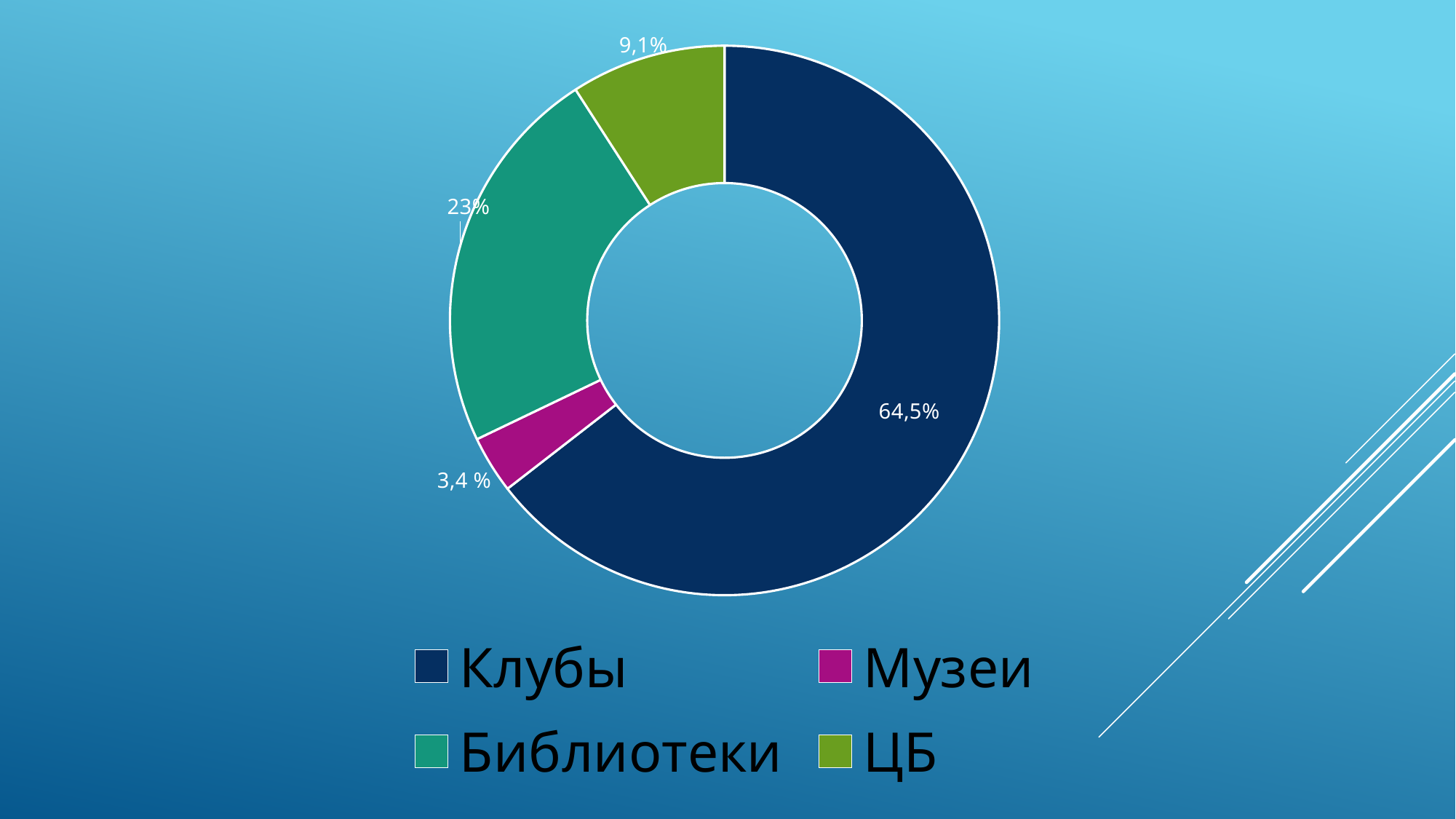
What share of the pie does Музеи have? 3,4 % Which category has the smallest slice of the pie? Музеи What share of the pie does Библиотеки have? 23% What kind of chart is shown on the slide? pie chart (doughnut) What colour is the Музеи slice in the chart? magenta Which slice is larger, Библиотеки or ЦБ? Библиотеки What is the difference in percentage points between the Клубы slice and the Библиотеки slice? 41,5 What share of the pie does Клубы have? 64,5% Which category has the largest slice of the pie? Клубы What share of the pie does ЦБ have? 9,1% Which slice is larger, Музеи or ЦБ? ЦБ How many categories does the chart show? 4